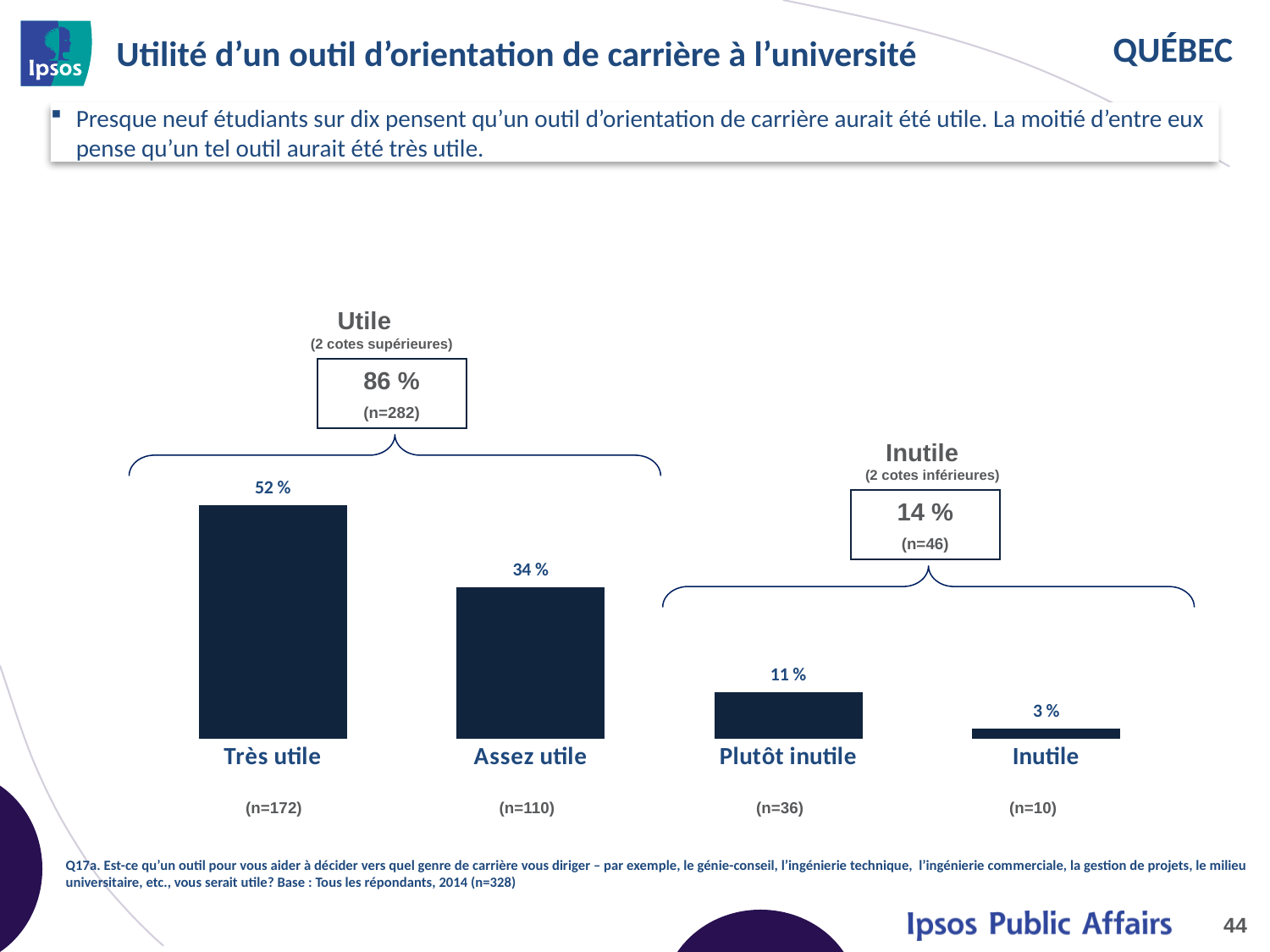
Which response category has the lowest percentage? Inutile What percentage of respondents answered "Assez utile"? 34 % What percentage of respondents answered "Très utile"? 52 % What is the difference in percentage points between "Très utile" and "Assez utile"? 18 What kind of chart is shown on the slide? Bar chart What is the sample size (n) shown for the "Plutôt inutile" category? n=36 What is the combined percentage shown for "Utile (2 cotes supérieures)"? 86 % How many response categories are shown as bars in the chart? 4 Which is larger, the percentage for "Assez utile" or for "Plutôt inutile"? Assez utile What percentage of respondents answered "Plutôt inutile"? 11 % What percentage of respondents answered "Inutile"? 3 % Which response category has the highest percentage? Très utile